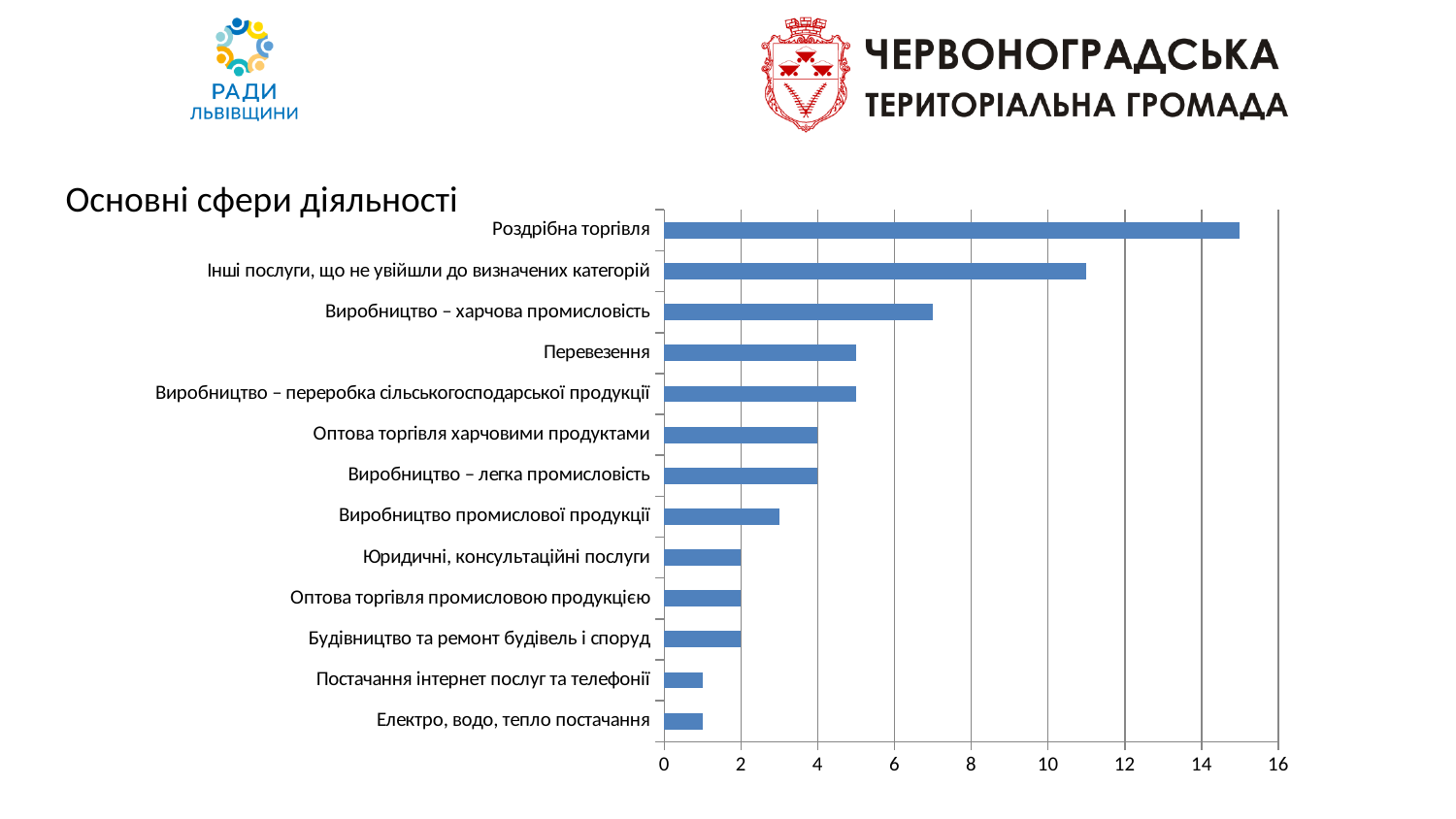
What is the value for Юридичні, консультаційні послуги? 2 Is the value for Роздрібна торгівля greater or less than 14? greater Which category has the highest value in the chart? Роздрібна торгівля What is the difference between the value for Оптова торгівля харчовими продуктами and the value for Будівництво та ремонт будівель і споруд? 2 What is the value for Оптова торгівля харчовими продуктами? 4 How many categories are plotted in the chart? 13 Which is larger: the value for Перевезення or the value for Виробництво промислової продукції? Перевезення Is the value for Виробництво – харчова промисловість greater or less than 8? less Is the value for Електро, водо, тепло постачання greater or less than 2? less What kind of chart is shown on the slide? bar chart What is the title of the chart? Основні сфери діяльності